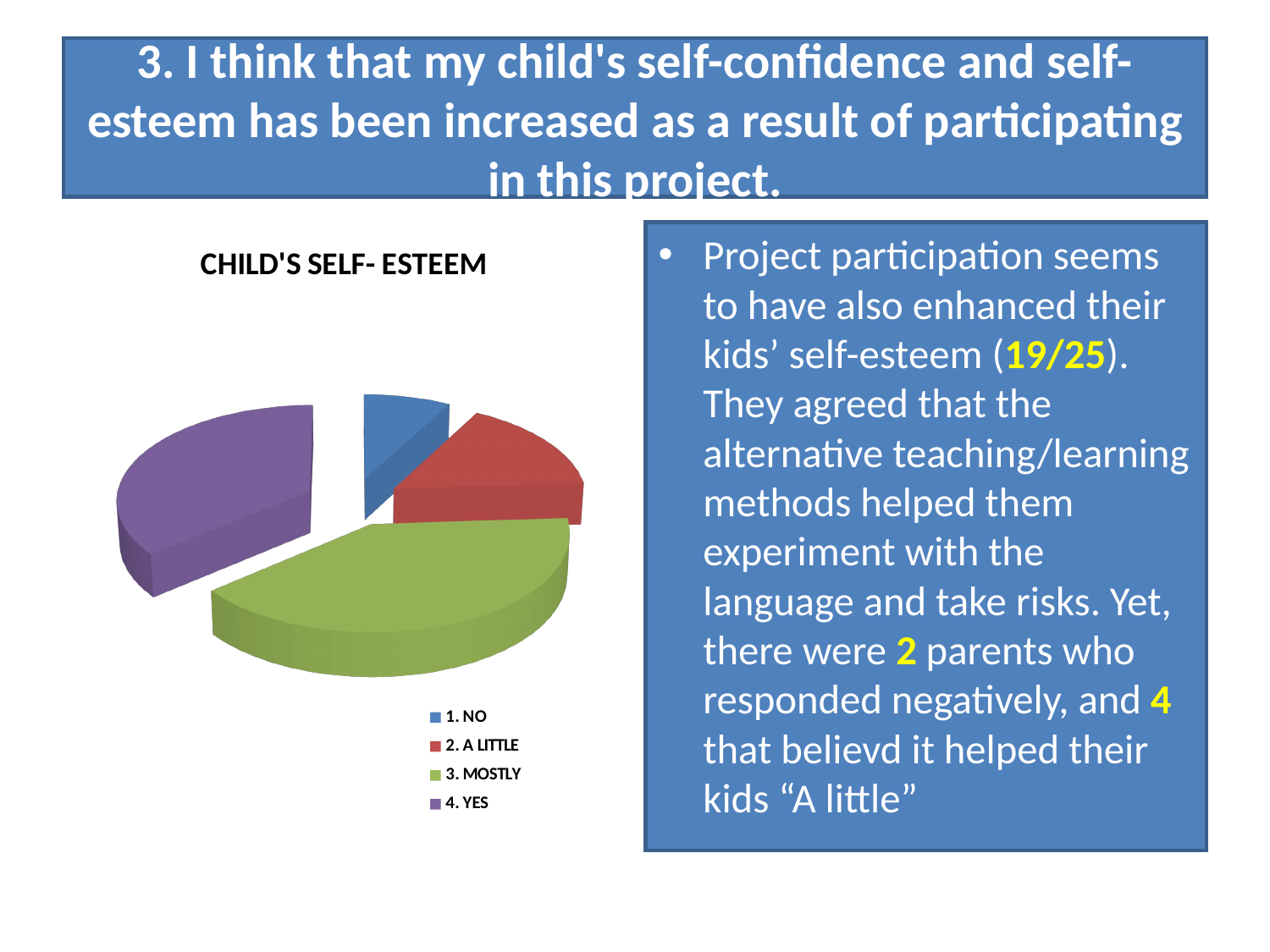
How many categories does the pie chart have? 4 Which category is shown in green in the pie chart? 3. MOSTLY Which category has the smallest slice of the pie? 1. NO Which slice is larger, 3. MOSTLY or 2. A LITTLE? 3. MOSTLY Which category has the second-largest slice of the pie? 4. YES Which category has the largest slice of the pie? 3. MOSTLY What kind of chart is shown on the slide? pie chart Which slice is larger, 4. YES or 1. NO? 4. YES Which slice is larger, 4. YES or 2. A LITTLE? 4. YES What is the title of the chart? CHILD'S SELF- ESTEEM